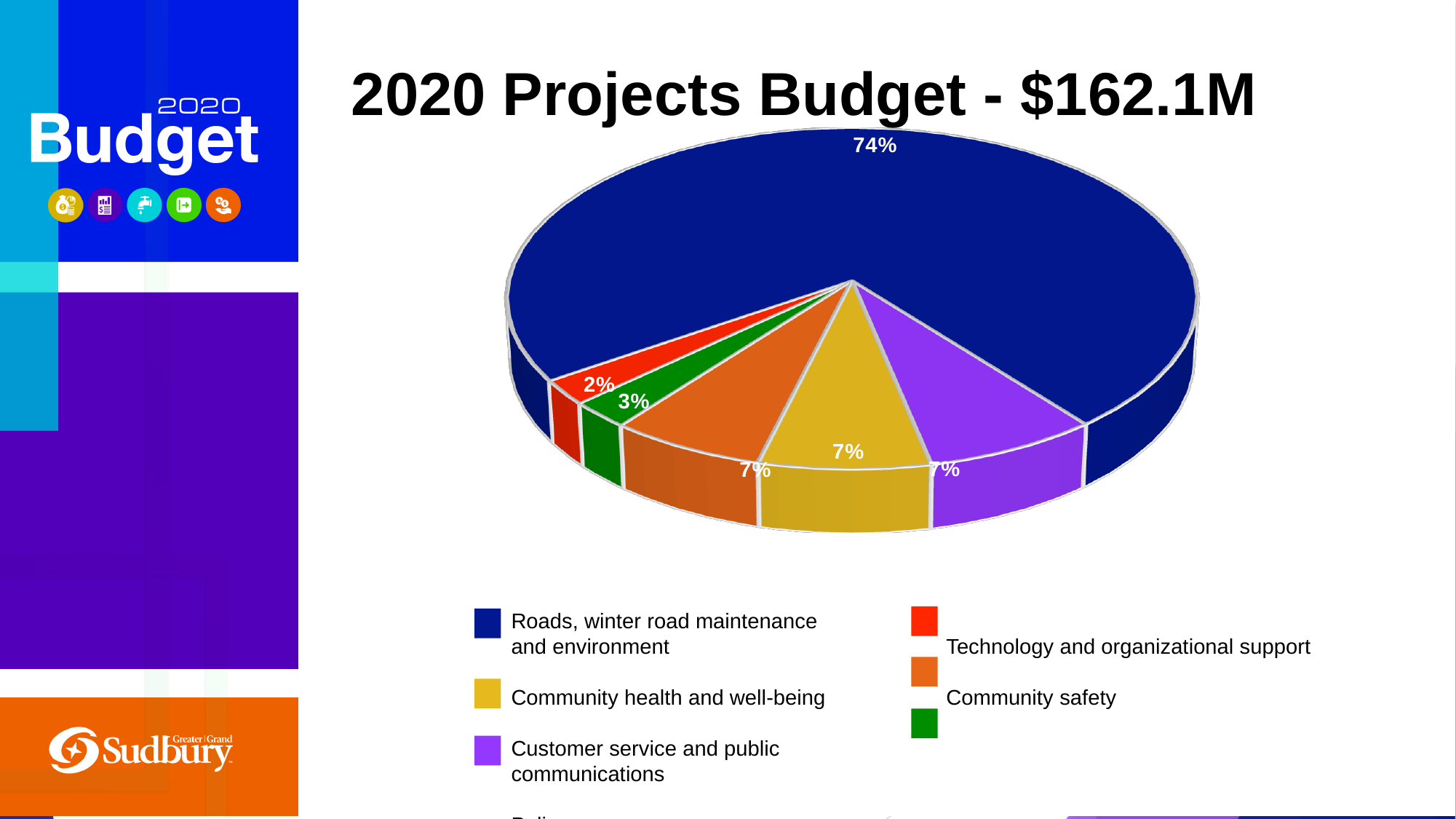
What percentage is shown for Customer service and public communications? 7% What share of the budget goes to Community health and well-being? 7% What kind of chart is shown on the slide? Pie chart What percentage of the budget is allocated to Technology and organizational support? 7% How many slices does the pie chart have? 6 What percentage of the 2020 Projects Budget goes to Roads, winter road maintenance and environment? 74% How many percentage points larger is the Roads, winter road maintenance and environment slice than the Technology and organizational support slice? 67 percentage points Which is larger: the share for Roads, winter road maintenance and environment or the share for Community safety? Roads, winter road maintenance and environment Which category has the largest slice of the pie? Roads, winter road maintenance and environment What is the title of the chart? 2020 Projects Budget - $162.1M What percentage of the budget is allocated to Community safety? 3%